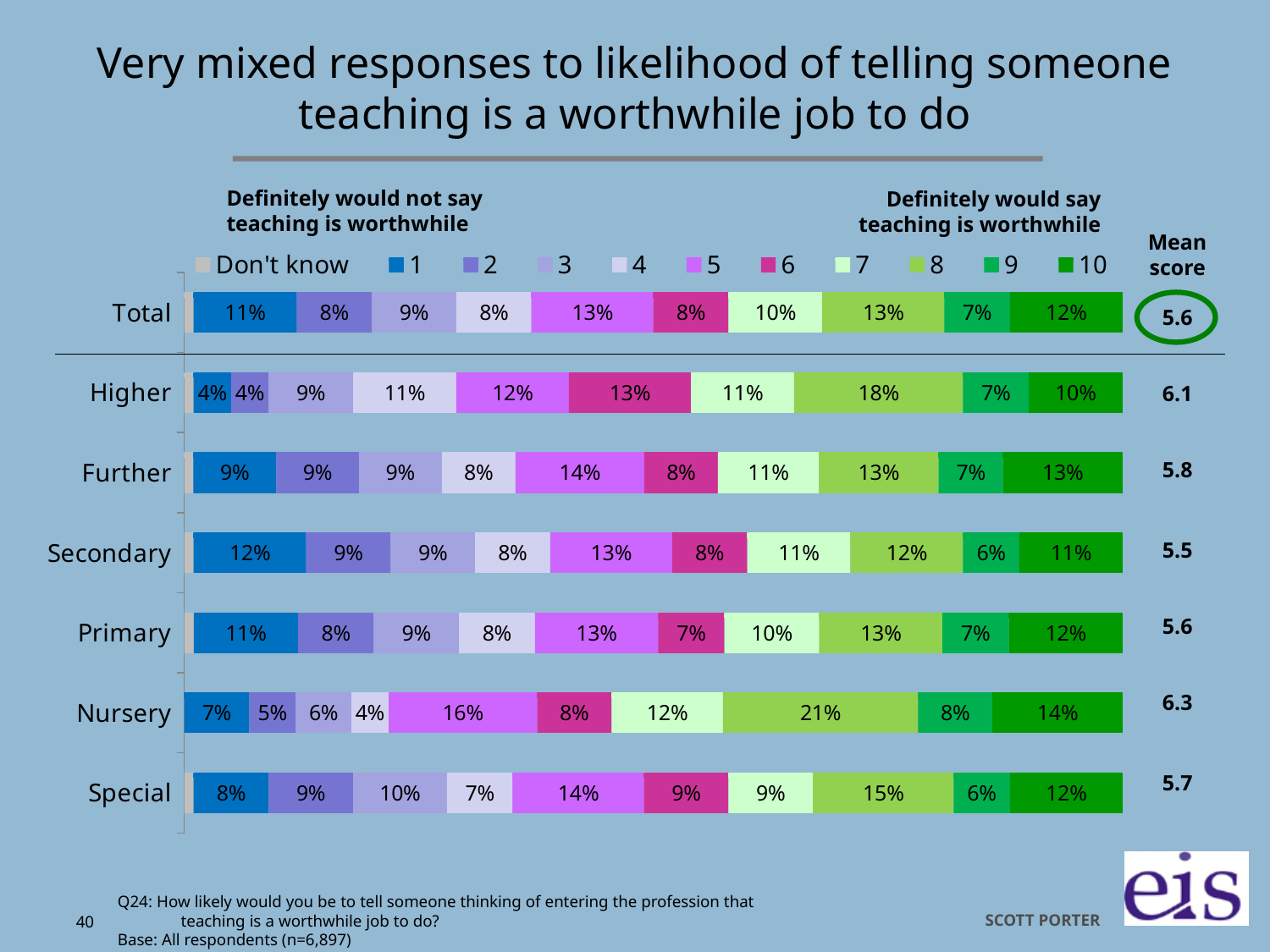
What percentage of Total respondents gave a score of 10? 12% How many series does the legend list? 11 Which category has the highest mean score? Nursery What percentage of Secondary respondents gave a score of 1? 12% Which is larger: the share of Higher respondents scoring 1 or the share of Further respondents scoring 1? Further What is the mean score for the Higher category? 6.1 Which category has the lowest mean score? Secondary What type of chart is shown on the slide? Stacked bar chart How many percentage points higher is the share of Nursery respondents scoring 8 than the share of Total respondents scoring 8? 8 percentage points How many categories (rows) are shown in the chart? 7 What percentage of Nursery respondents gave a score of 8? 21% What is the first entry in the chart's legend? Don't know